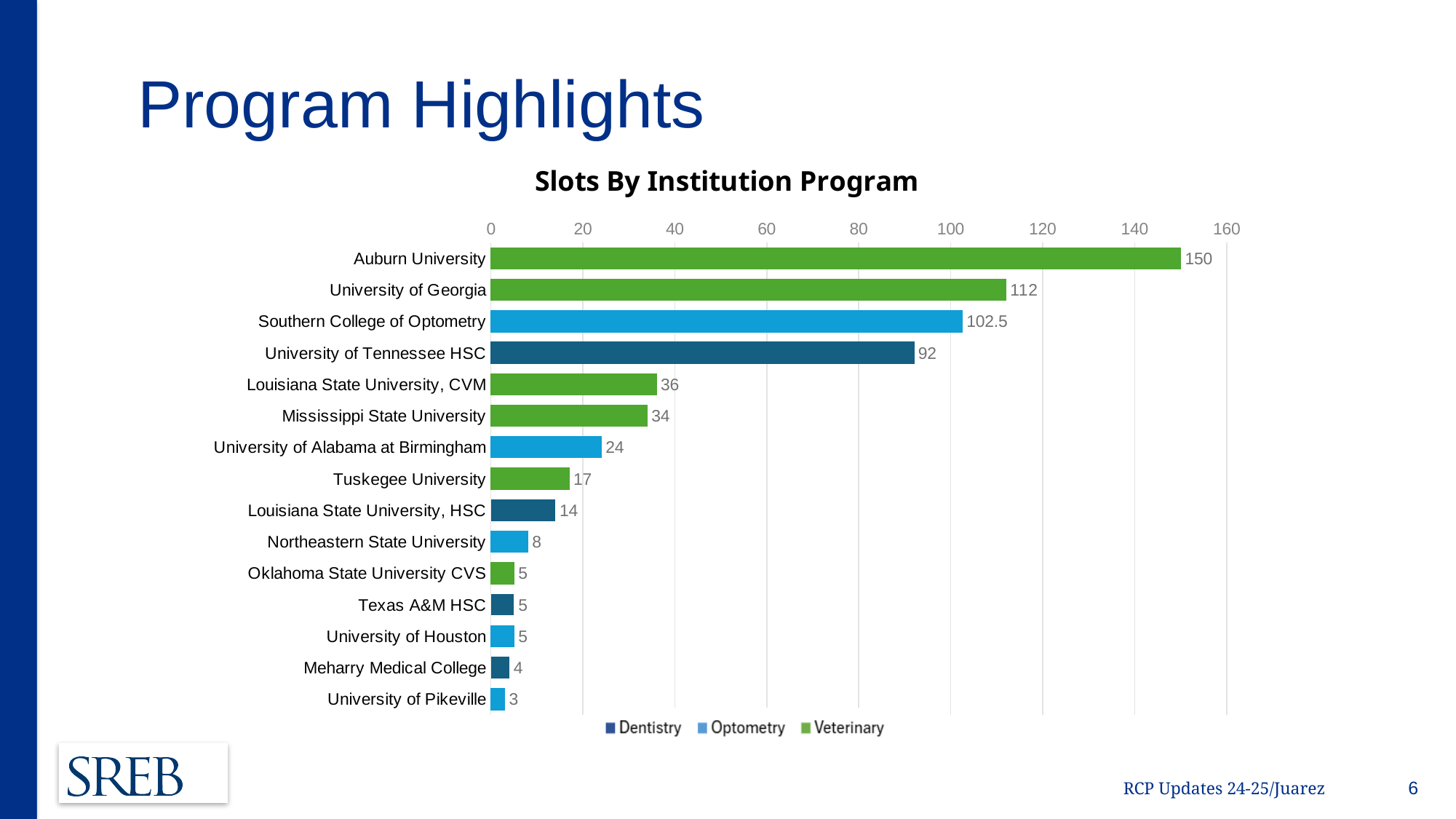
What is the difference between the values for Auburn University and University of Georgia? 38 How many institutions are shown in the chart? 15 What kind of chart is shown on the slide? bar chart What is the title of the chart? Slots By Institution Program What is the value for Southern College of Optometry? 102.5 How many series does the legend list? 3 What is the value for Auburn University in the Slots By Institution Program chart? 150 Which institution has the lowest number of slots? University of Pikeville What is the value for University of Tennessee HSC? 92 Which institution has the highest number of slots? Auburn University Which series does the legend show in green? Veterinary Which is larger, the value for Louisiana State University, CVM or Mississippi State University? Louisiana State University, CVM